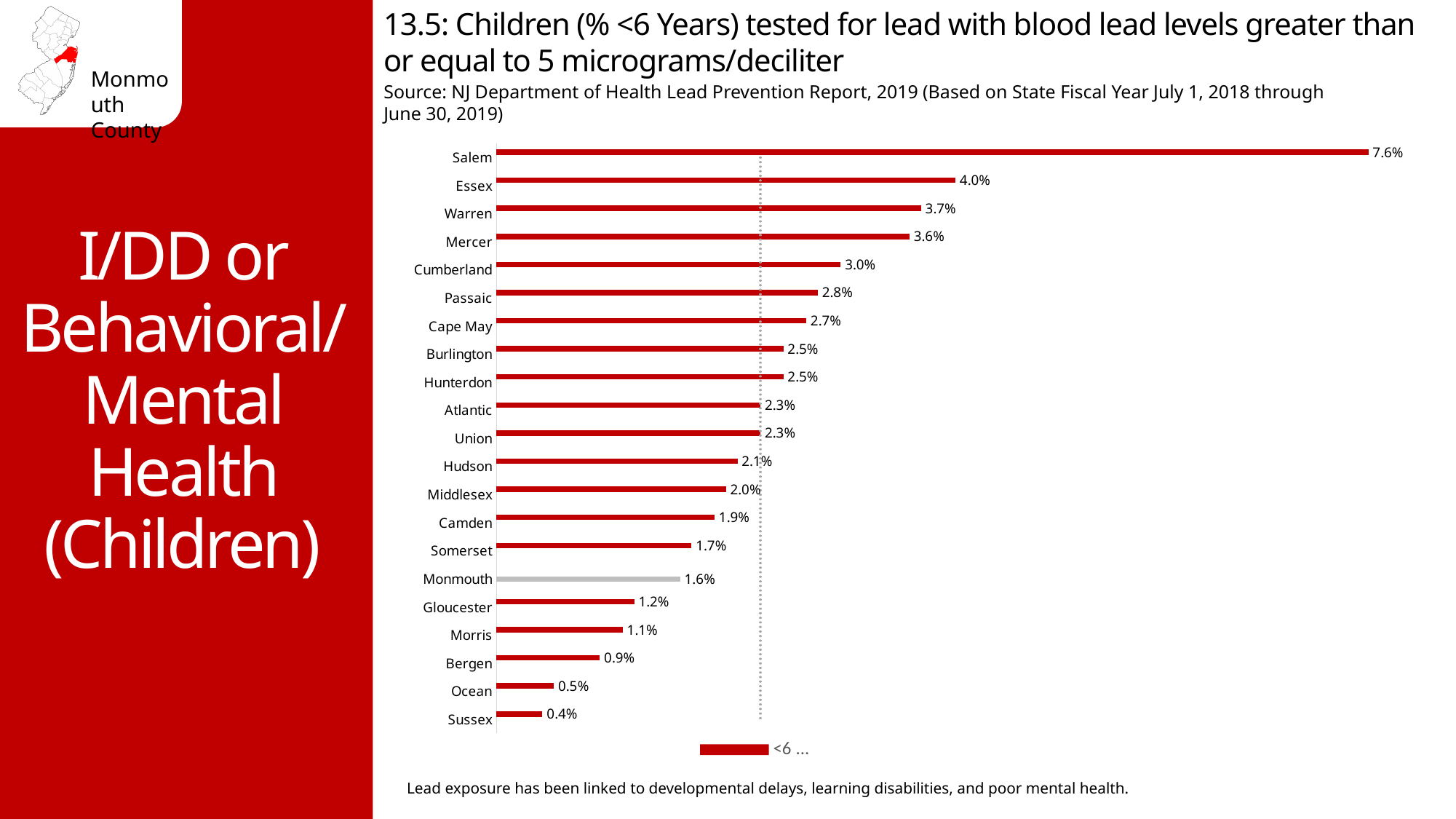
How many counties are shown in the chart? 21 What is the difference between the values for Monmouth and Sussex? 1.2% Which county has the highest value? Salem What is the difference between the values for Salem and Essex? 3.6% Which is larger, the value for Bergen or the value for Gloucester? Gloucester What is the value for Salem? 7.6% What is the value for Monmouth? 1.6% Which county has the lowest value? Sussex What is the value for Cumberland? 3.0% Which county's bar is shown in grey rather than red? Monmouth Which is larger, the value for Mercer or the value for Passaic? Mercer What kind of chart is shown on the slide? Bar chart